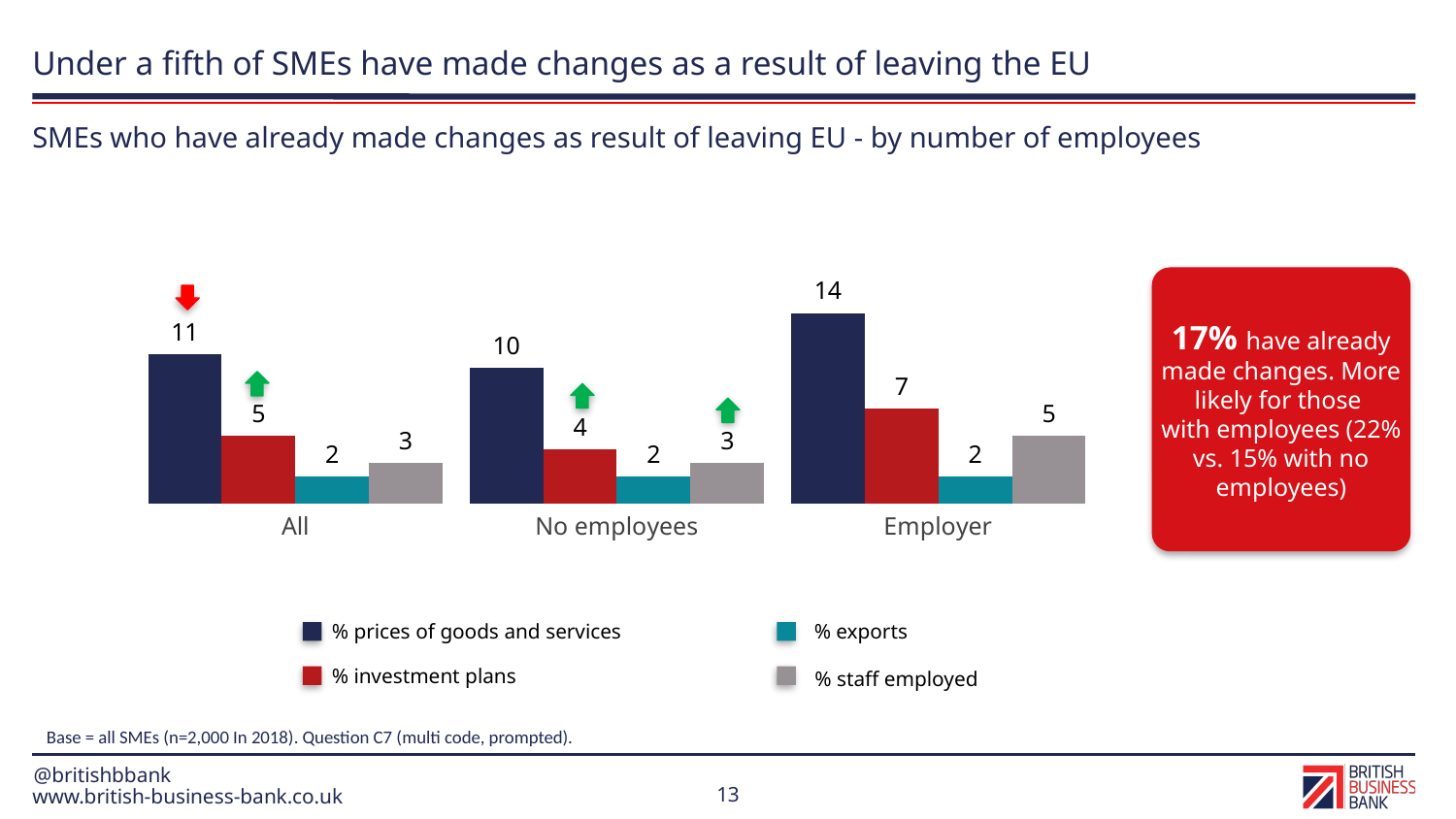
What is the value for % prices of goods and services in the Employer category? 14 What is the value for % exports in the Employer category? 2 What is the title of the chart? SMEs who have already made changes as result of leaving EU - by number of employees Which series has the lowest value in the All category? % exports What is the value for % investment plans in the All category? 5 What is the difference between % prices of goods and services for Employer and for No employees? 4 Which category has the highest value for % prices of goods and services? Employer How many series does the legend list? 4 How many categories are shown on the x axis? 3 Which is larger: % investment plans for Employer or % investment plans for No employees? Employer What kind of chart is shown on the slide? Bar chart What is the value for % staff employed in the No employees category? 3